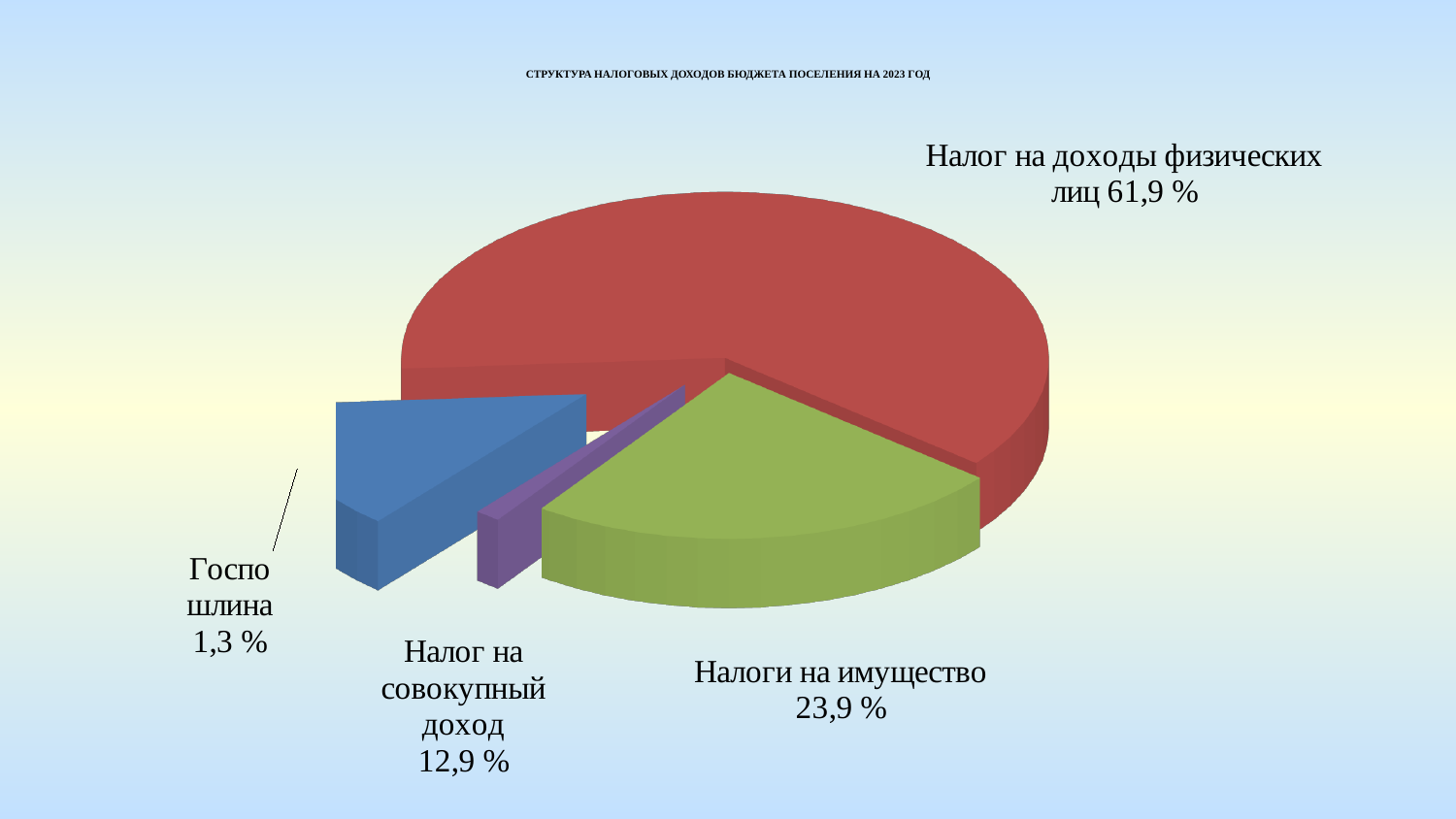
Сколько категорий (секторов) показано на диаграмме? 4 На сколько процентных пунктов доля налогов на имущество больше доли налога на совокупный доход? 11 % Какая категория имеет наименьшую долю в структуре налоговых доходов? Госпошлина Какой тип диаграммы показан на слайде? Круговая диаграмма Какова доля налогов на имущество? 23,9 % Как называется диаграмма на слайде? Структура налоговых доходов бюджета поселения на 2023 год На сколько процентных пунктов доля налога на доходы физических лиц больше доли налогов на имущество? 38 % Какая категория имеет наибольшую долю в структуре налоговых доходов? Налог на доходы физических лиц Какова доля налога на доходы физических лиц в структуре налоговых доходов? 61,9 % Какова доля налога на совокупный доход? 12,9 % Какова доля госпошлины? 1,3 % Что больше: доля налога на совокупный доход или доля госпошлины? Налог на совокупный доход